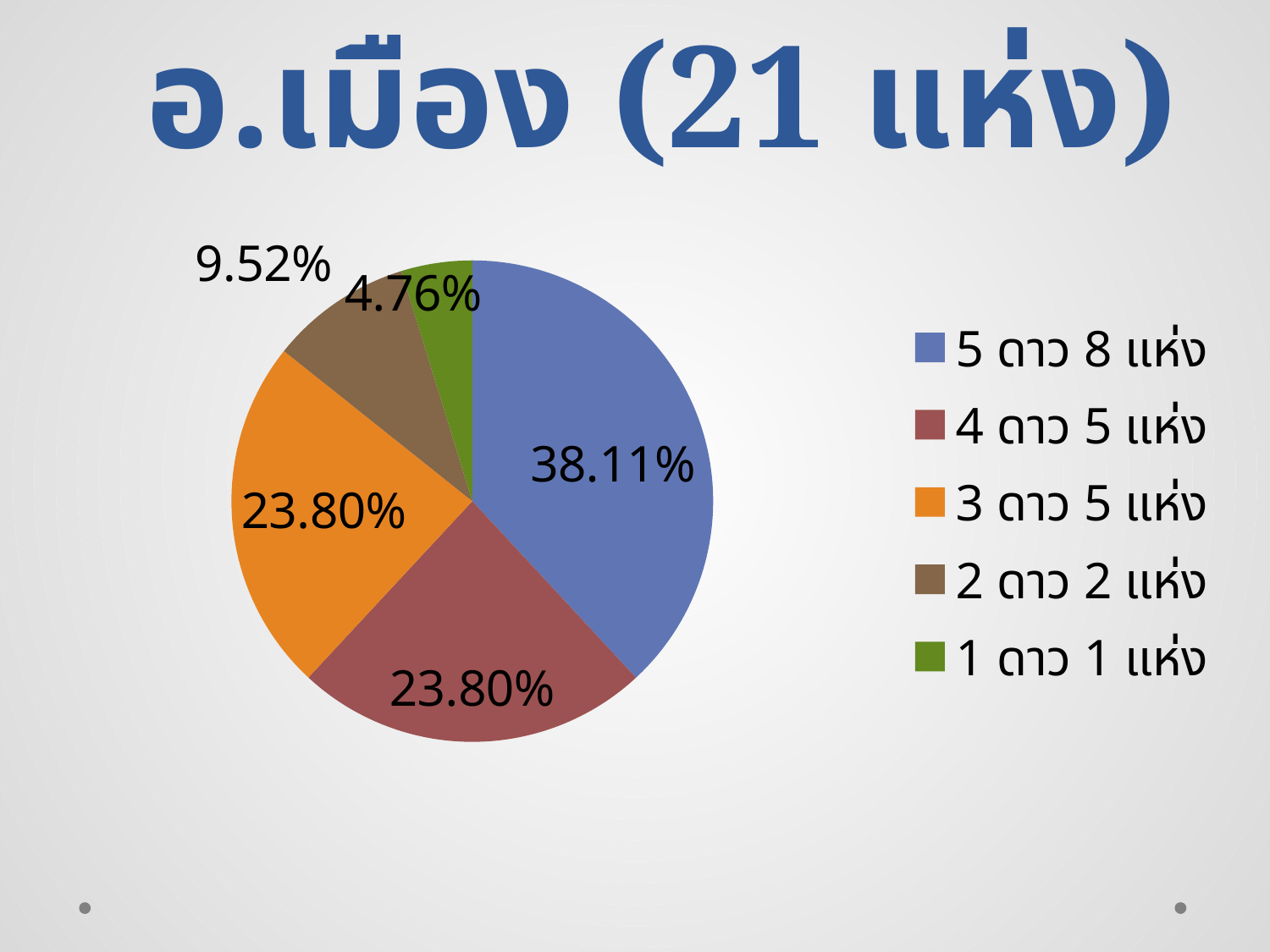
Which category has the largest slice of the pie? 5 ดาว 8 แห่ง What percentage share does the slice for 4 ดาว 5 แห่ง have? 23.80% What percentage share does the slice for 2 ดาว 2 แห่ง have? 9.52% What colour is the slice for 3 ดาว 5 แห่ง? orange Which category has the smallest slice of the pie? 1 ดาว 1 แห่ง How many slices does the pie chart have? 5 What is the title of the chart on the slide? อ.เมือง (21 แห่ง) What is the difference in percentage points between the 5 ดาว 8 แห่ง slice and the 2 ดาว 2 แห่ง slice? 28.59 What kind of chart is shown on the slide? pie chart What percentage share does the slice for 5 ดาว 8 แห่ง have? 38.11% Which slice is larger, 3 ดาว 5 แห่ง or 1 ดาว 1 แห่ง? 3 ดาว 5 แห่ง